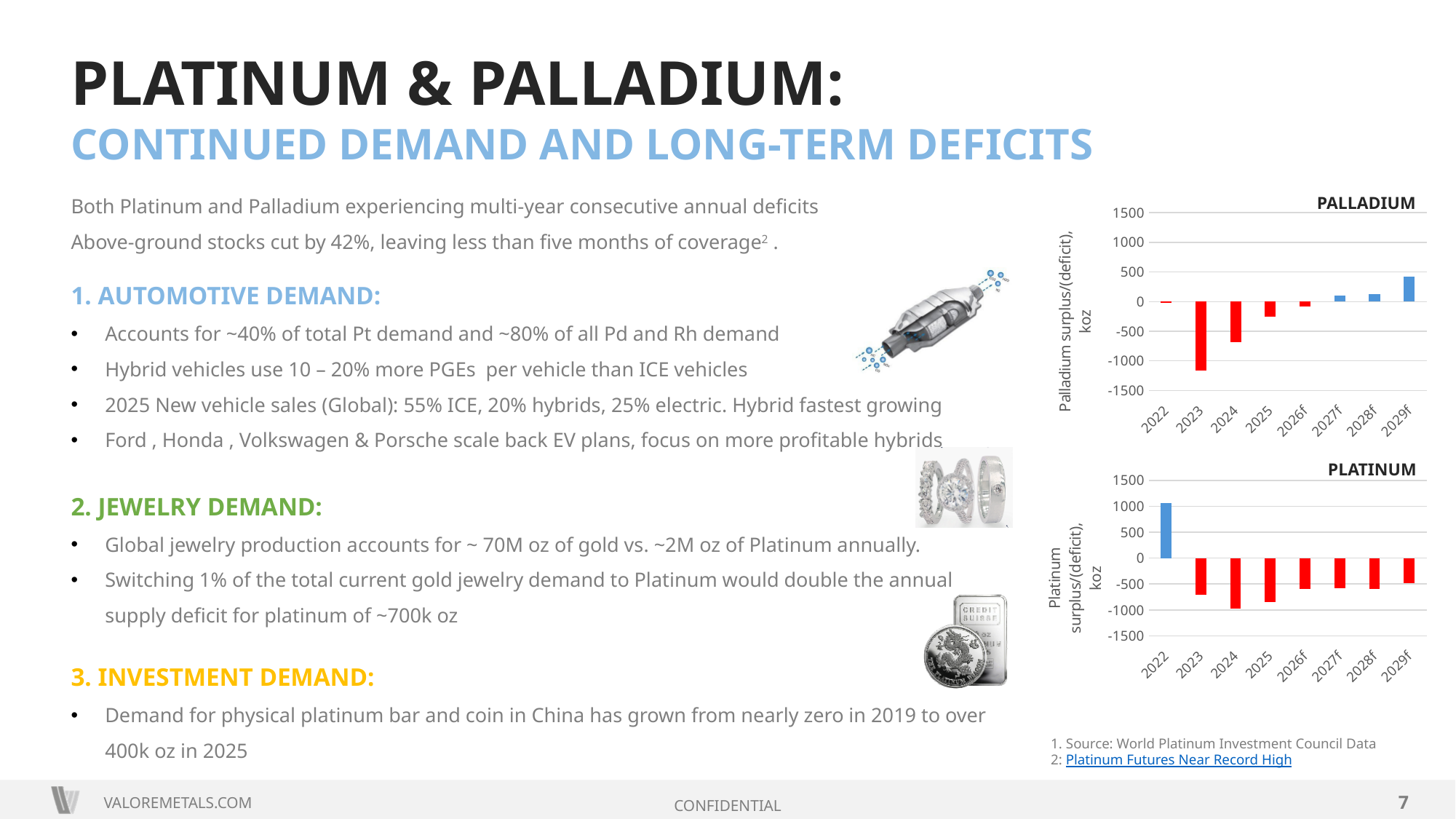
In the PALLADIUM chart, do the values rise or fall from 2023 to 2029f? rise In the PALLADIUM chart, which is larger, the value for 2024 or the value for 2025? 2025 In the PLATINUM chart, which year has the lowest value (largest deficit)? 2024 In the PALLADIUM chart, which year has the highest value? 2029f In the PALLADIUM chart, is the value for 2023 greater or less than -1000? less How many years are shown on the x axis of the PLATINUM chart? 8 In the PLATINUM chart, is the value for 2024 greater or less than -500? less In the PLATINUM chart, which year has the highest value? 2022 What kind of chart is the PALLADIUM chart? bar chart What colour are the deficit (negative) bars in the PLATINUM chart? red In the PALLADIUM chart, which year has the lowest value (largest deficit)? 2023